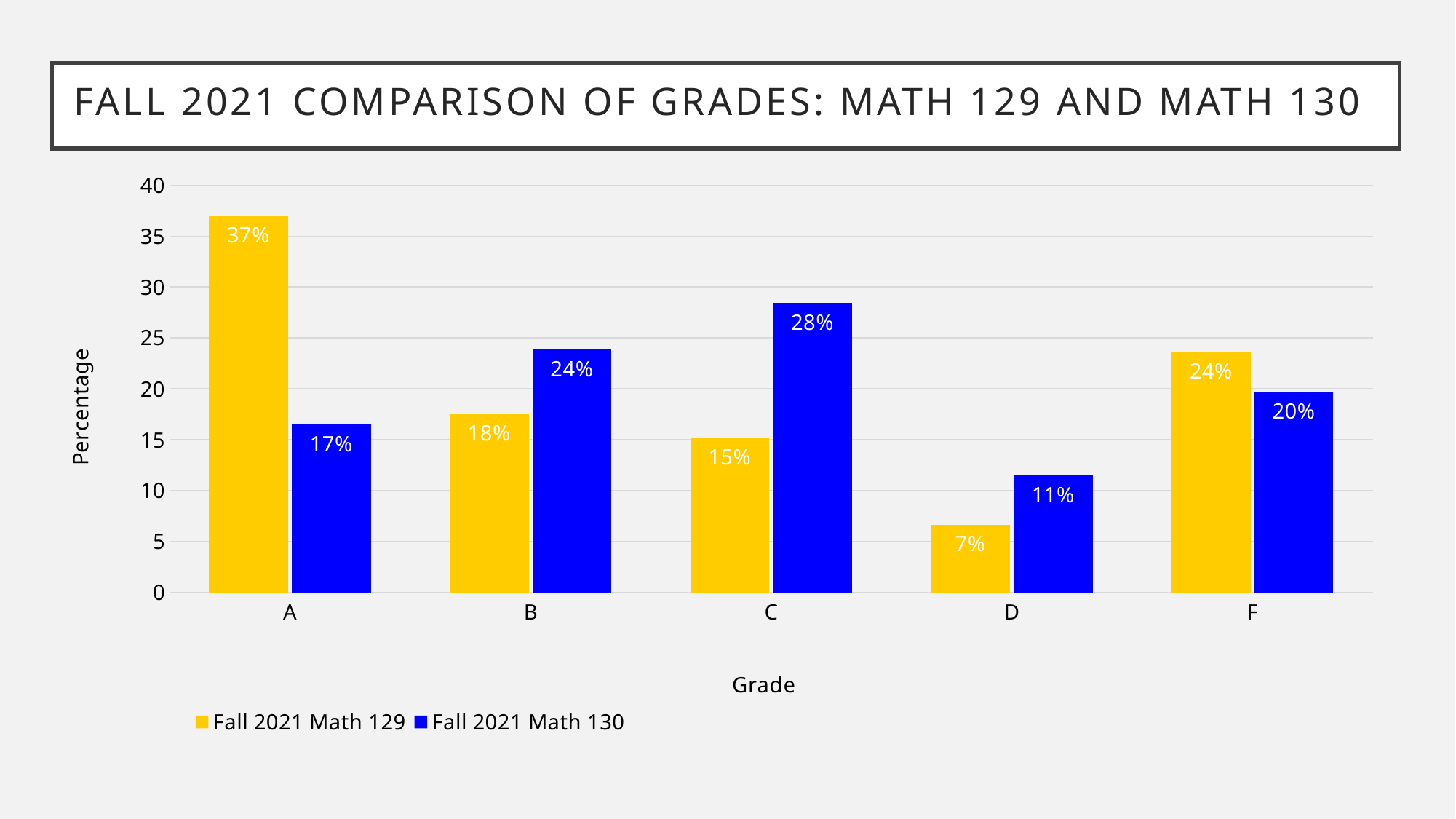
How many series does the legend list? 2 Is the Fall 2021 Math 129 value for grade F greater or less than 20? greater Which grade has the highest percentage for Fall 2021 Math 129? A What kind of chart is shown on the slide? Bar chart What is the label of the y axis? Percentage What percentage of Fall 2021 Math 130 students received a C? 28% Which grade has the lowest percentage for Fall 2021 Math 130? D How many grade categories are shown on the x axis? 5 What percentage of Fall 2021 Math 129 students received an A? 37% What is the value for grade D in the Fall 2021 Math 130 series? 11% For grade B, which series has the larger percentage, Fall 2021 Math 129 or Fall 2021 Math 130? Fall 2021 Math 130 What is the difference between the Fall 2021 Math 129 and Fall 2021 Math 130 percentages for grade A? 20%